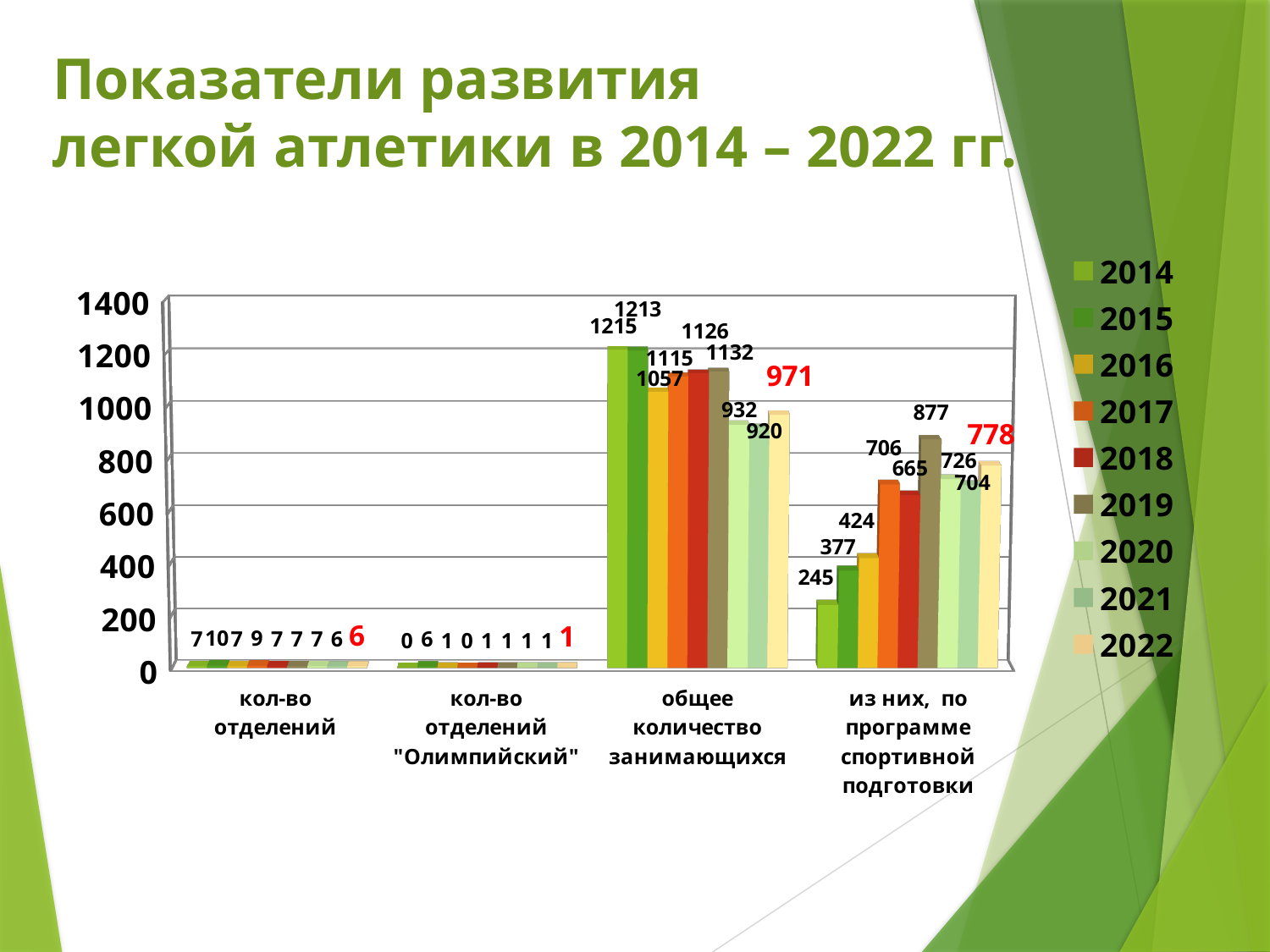
Is the value for 2020 in the category "общее количество занимающихся" greater or less than 1000? less What is the value for 2019 in the category "из них, по программе спортивной подготовки"? 877 In the category "из них, по программе спортивной подготовки", which year has the larger value, 2017 or 2018? 2017 How many series (years) does the legend list? 9 What is the value for 2022 in the category "общее количество занимающихся"? 971 How many categories are shown along the x axis? 4 What kind of chart is shown on the slide? bar chart Which year has the lowest value in the category "из них, по программе спортивной подготовки"? 2014 What is the title of the slide? Показатели развития легкой атлетики в 2014 – 2022 гг. What is the value for 2015 in the category "кол-во отделений"? 10 Which year has the highest value in the category "из них, по программе спортивной подготовки"? 2019 What is the difference between the 2022 and 2021 values in the category "общее количество занимающихся"? 51